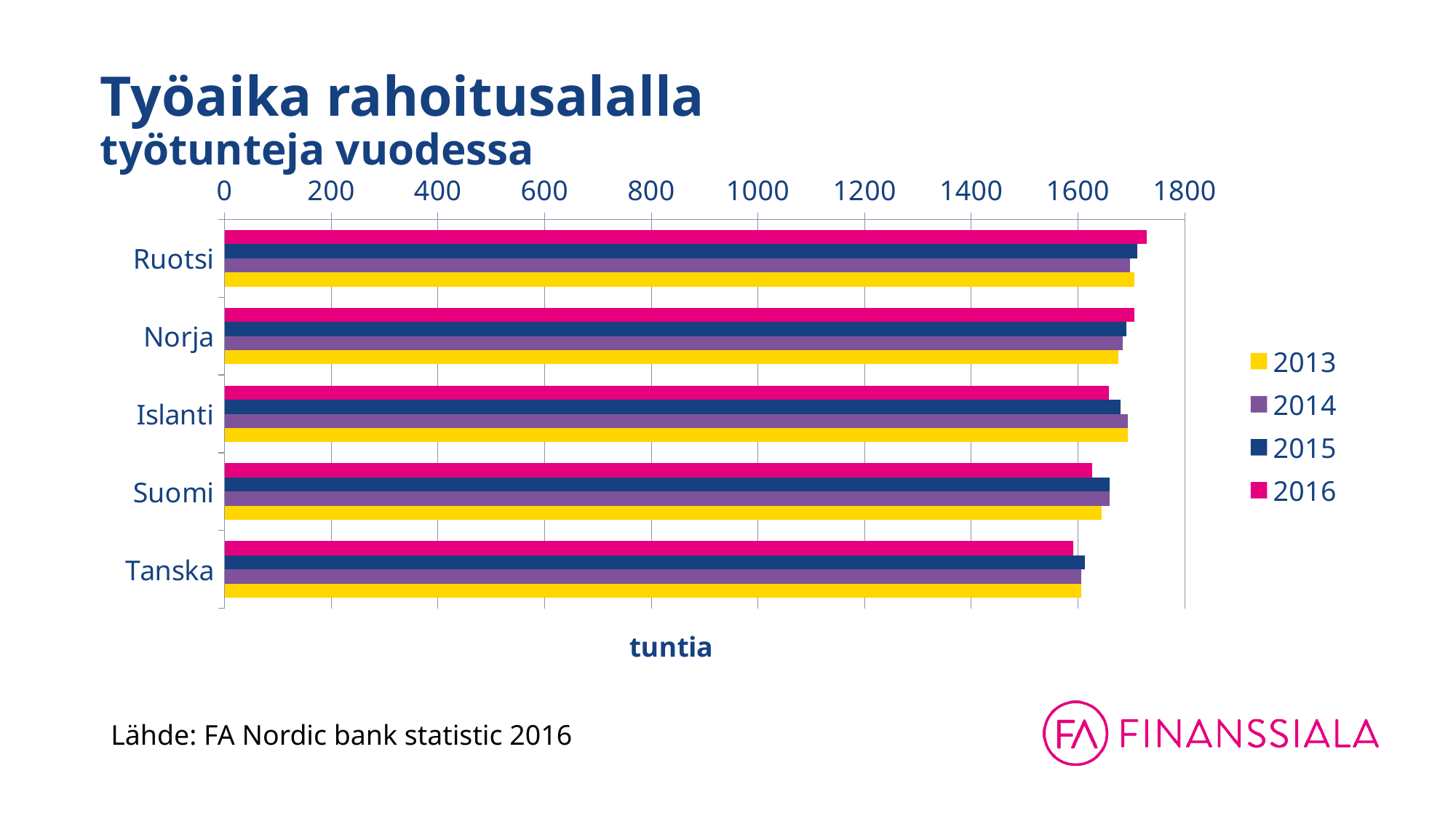
What is the label on the horizontal axis of the chart? tuntia Which country has the longest bar for 2016? Ruotsi How many countries are shown on the chart? 5 Which is larger, the 2016 value for Ruotsi or the 2016 value for Tanska? Ruotsi Which country has the shortest bar for 2016? Tanska Which year does the yellow series in the legend represent? 2013 Is the value for Ruotsi in 2016 greater or less than 1800? less What kind of chart is shown on the slide? bar chart How many series does the legend list? 4 Which is larger, the 2013 value for Ruotsi or the 2013 value for Tanska? Ruotsi Is the value for Ruotsi in 2016 greater or less than 1600? greater Is the value for Tanska in 2015 greater or less than 1400? greater